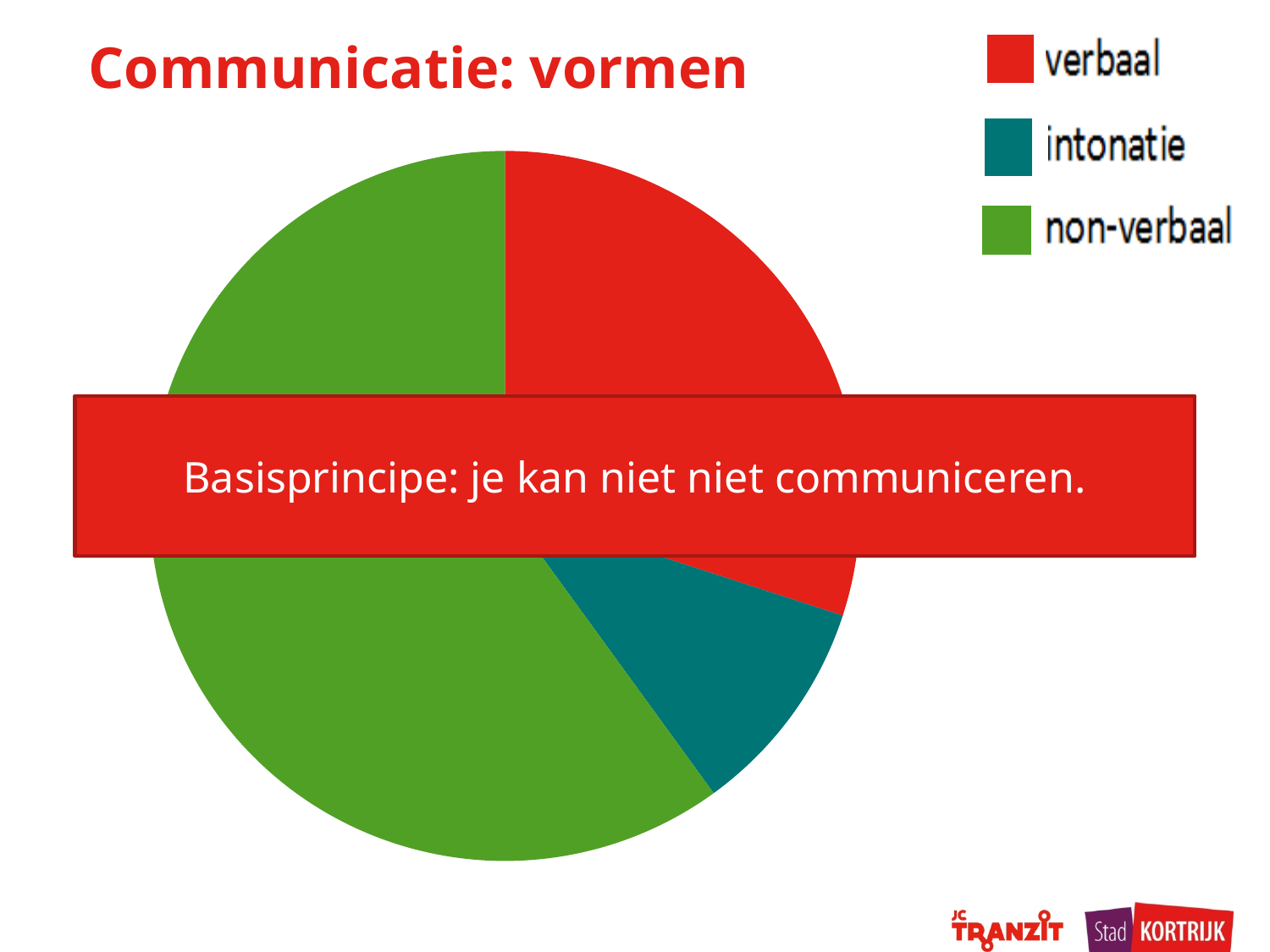
What kind of chart is shown on the slide? pie chart Which slice is larger in the pie chart, verbaal or intonatie? verbaal Which category has the smallest slice in the pie chart? intonatie Which slice is larger in the pie chart, non-verbaal or verbaal? non-verbaal What colour is the verbaal slice in the pie chart? red Which slice is larger in the pie chart, non-verbaal or intonatie? non-verbaal How many entries does the legend of the pie chart list? 3 How many slices does the pie chart have? 3 What is the title of the slide containing the pie chart? Communicatie: vormen Which category has the largest slice in the pie chart? non-verbaal